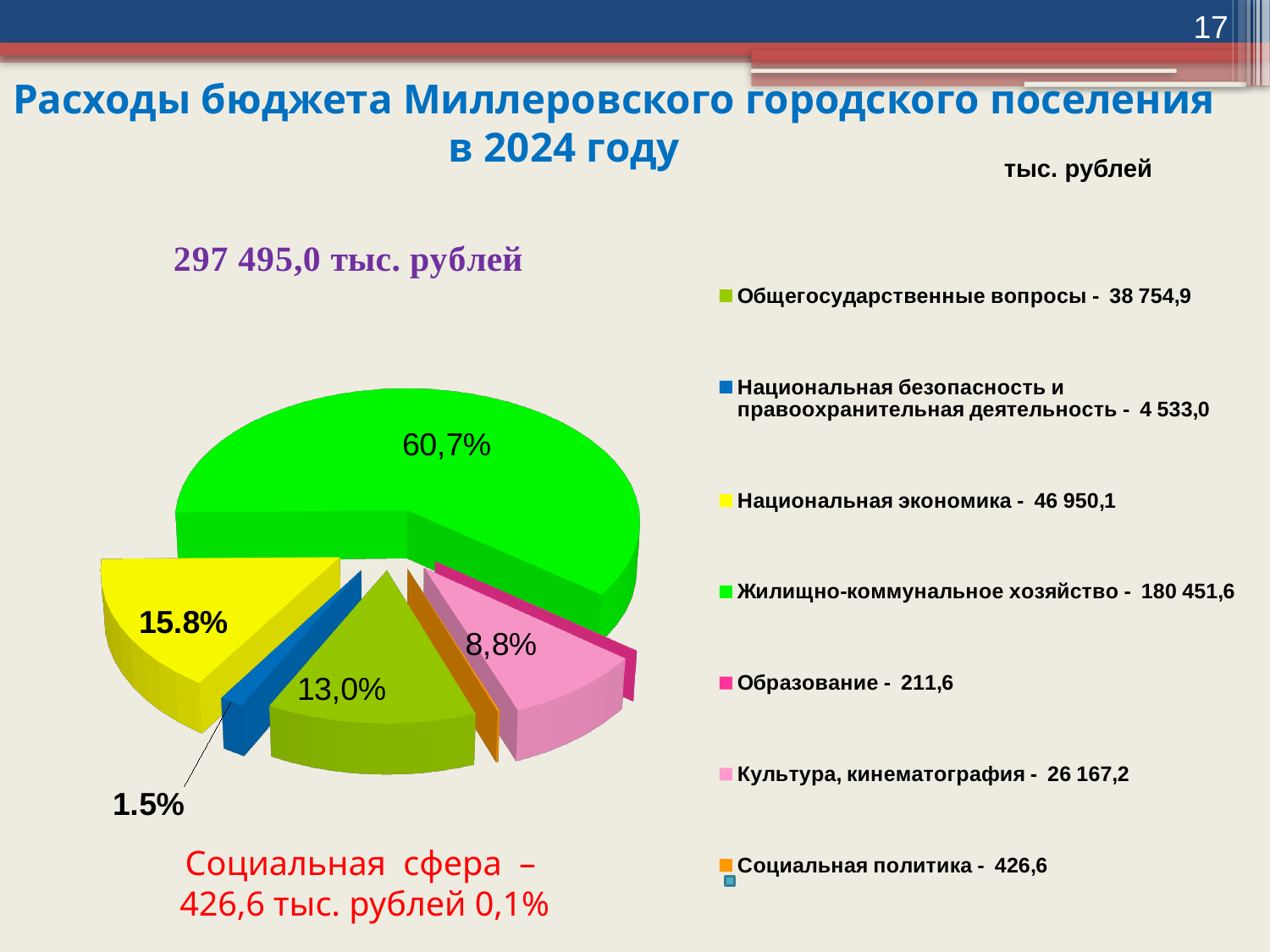
Which is larger, Общегосударственные вопросы or Культура, кинематография? Общегосударственные вопросы What is the value for Культура, кинематография? 26 167,2 What total amount of expenditures is stated on the slide? 297 495,0 тыс. рублей What is the difference between Национальная экономика and Общегосударственные вопросы? 8 195,2 Which category has the largest expenditure? Жилищно-коммунальное хозяйство What is the value for Жилищно-коммунальное хозяйство? 180 451,6 What share of the pie does Национальная экономика take? 15.8% How many categories does the legend list? 7 What is the value for Национальная экономика? 46 950,1 Which category has the smallest expenditure? Образование What kind of chart is shown on the slide? pie chart What share of the pie does Жилищно-коммунальное хозяйство take? 60,7%